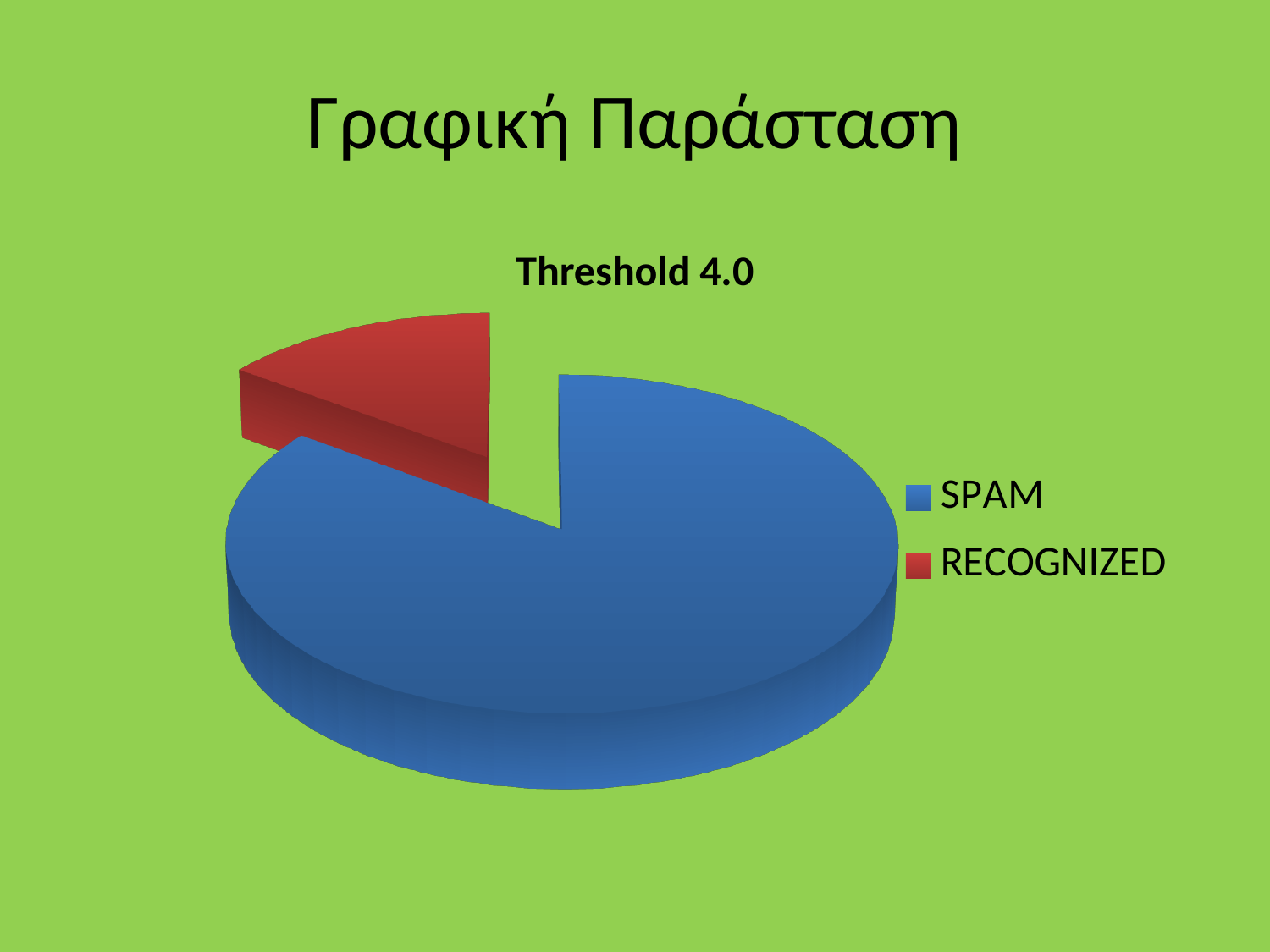
What is the title of the chart? Threshold 4.0 Which legend entry is shown in red? RECOGNIZED Which slice is the largest in the pie chart? SPAM Which slice is the smallest in the pie chart? RECOGNIZED How many entries does the legend list? 2 Which slice is larger, SPAM or RECOGNIZED? SPAM What colour is the SPAM slice? blue What kind of chart is shown on the slide? pie chart How many slices does the pie chart have? 2